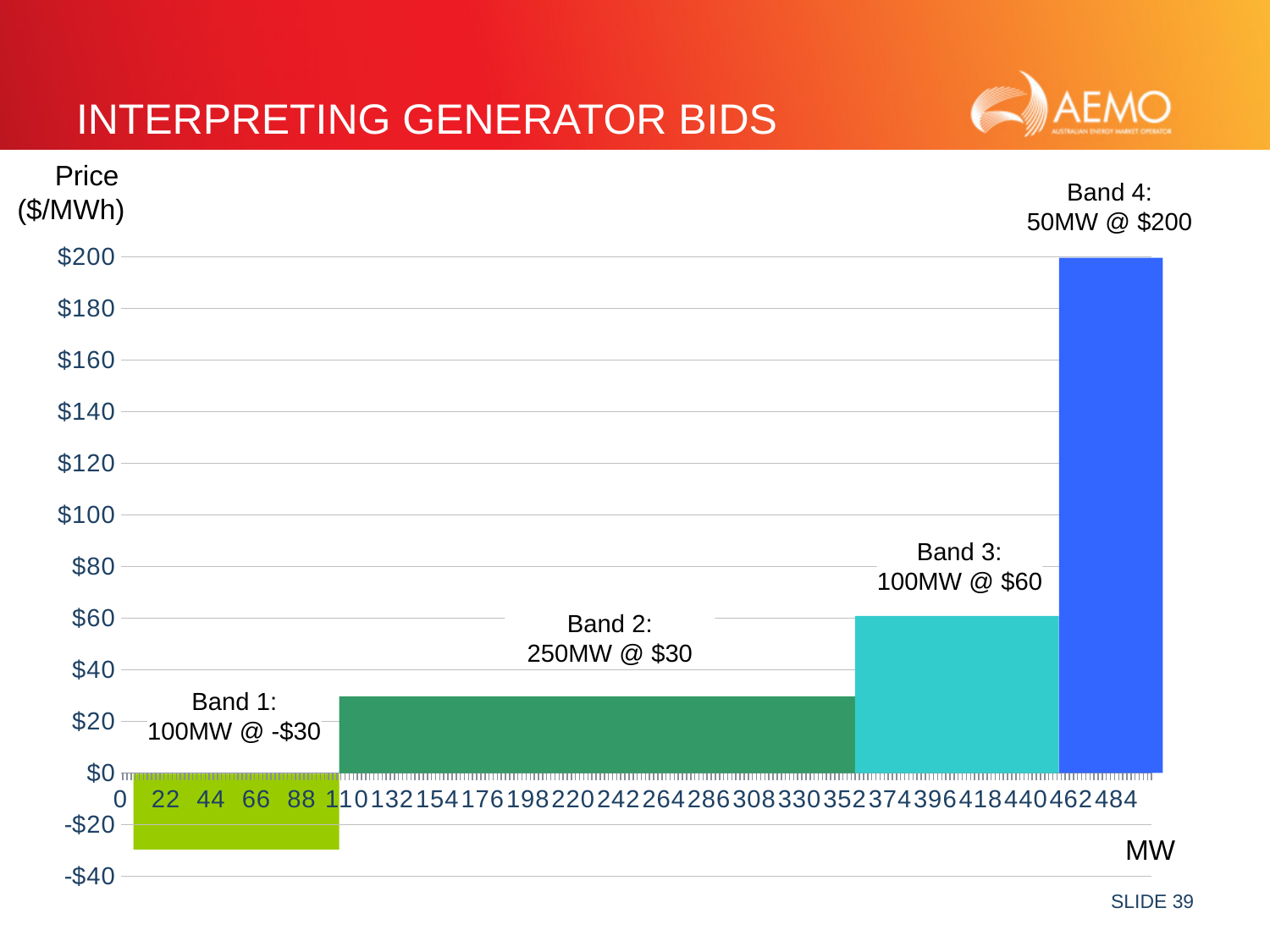
How many MW are offered in Band 2? 250MW Which has a higher bid price, Band 2 or Band 3? Band 3 Is the price for Band 3 greater or less than $80? less What is the difference in price between Band 4 and Band 3? $140 Do the bid prices rise or fall as MW increases along the x axis? rise What is the bid price for Band 4? $200 What kind of chart is shown on the slide? bar chart What is the bid price for Band 2? $30 What is the bid price for Band 1? -$30 Which band has the lowest bid price? Band 1 Which band has the highest bid price? Band 4 How many bid bands are shown on the chart? 4